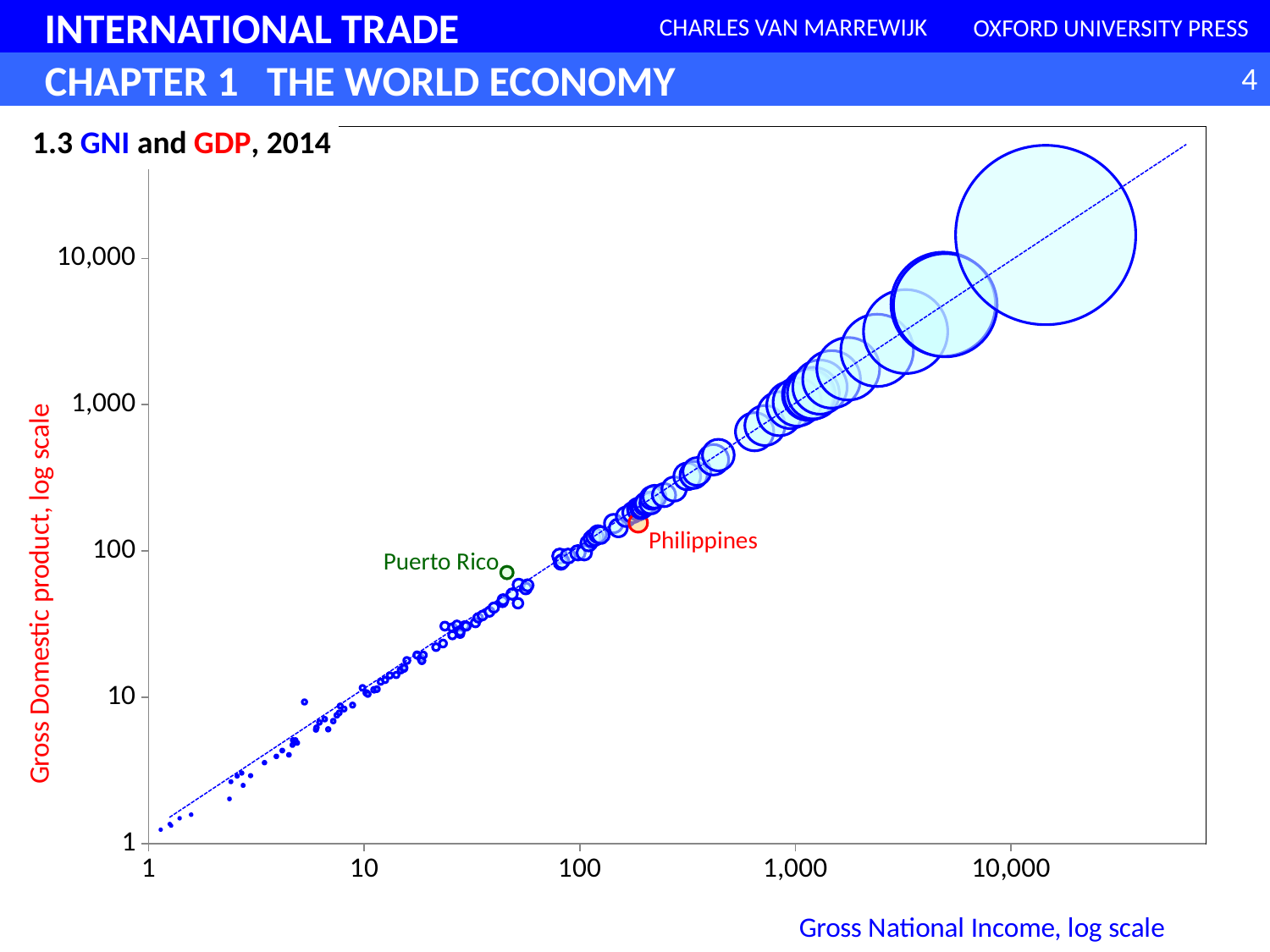
Which has the higher Gross Domestic product, Puerto Rico or the Philippines? Philippines Is the Gross National Income value for Puerto Rico greater or less than 10? greater Is the Gross Domestic product value for the Philippines greater or less than 1,000? less Which has the higher Gross National Income, Puerto Rico or the Philippines? Philippines What is the label of the horizontal axis of the chart? Gross National Income, log scale How many countries are labelled by name on the chart? 2 Is the Gross Domestic product value for Puerto Rico greater or less than 100? less What kind of chart is shown on the slide? Scatter (bubble) chart As Gross National Income increases along the x axis, does Gross Domestic product rise or fall? rise What is the title of the chart? 1.3 GNI and GDP, 2014